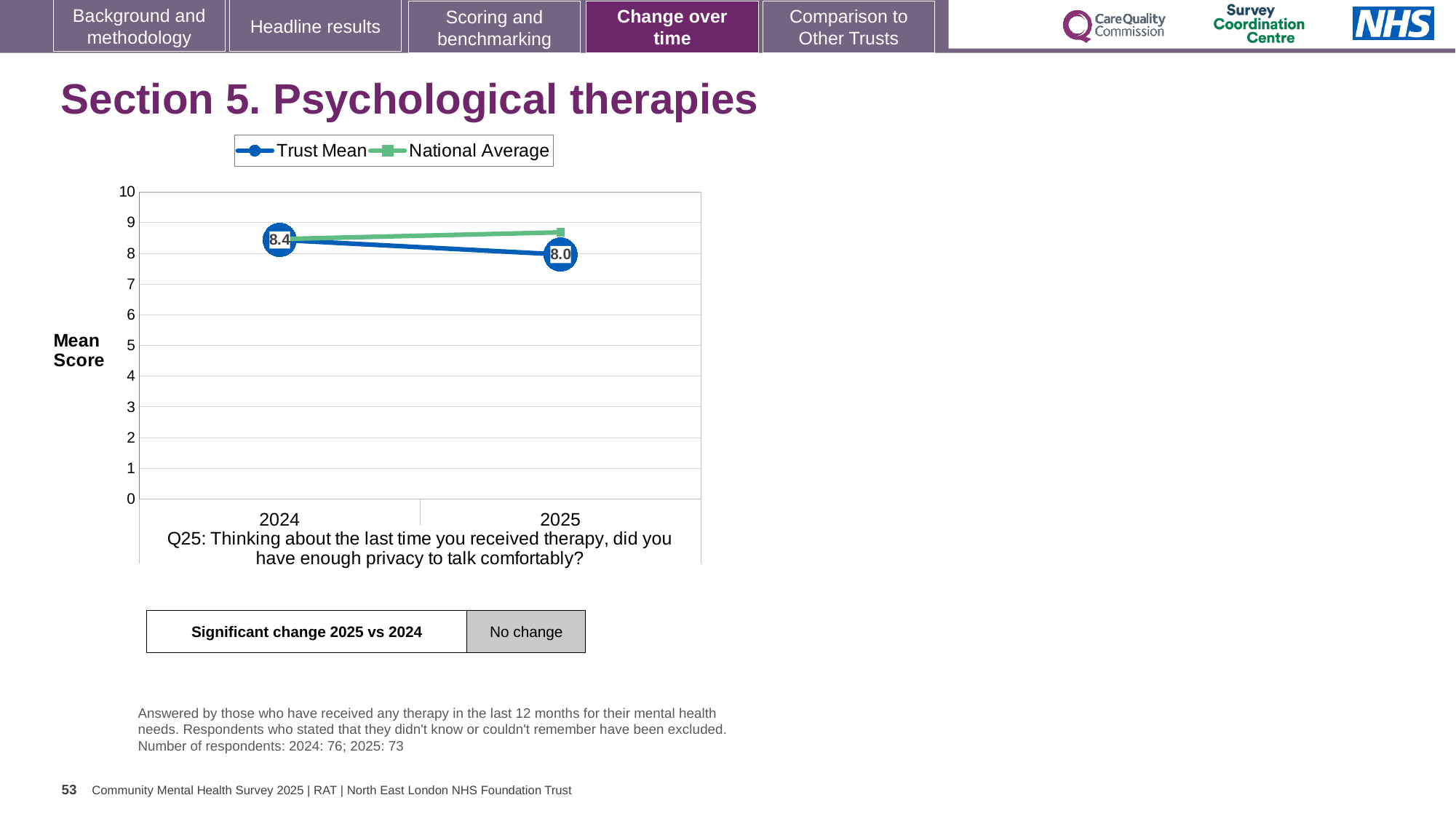
Does the National Average rise or fall from 2024 to 2025? rise What is the label on the y axis of the chart? Mean Score By how much did the Trust Mean score change from 2024 to 2025? 0.4 What is the Trust Mean score for 2024? 8.4 Which year has the higher Trust Mean score, 2024 or 2025? 2024 Is the National Average value for 2025 greater or less than 8? greater In 2025, which is higher, the Trust Mean or the National Average? National Average How many years are plotted on the x axis? 2 Does the Trust Mean rise or fall from 2024 to 2025? fall What is the Trust Mean score for 2025? 8.0 What kind of chart is shown on the slide? line chart How many series does the legend list? 2